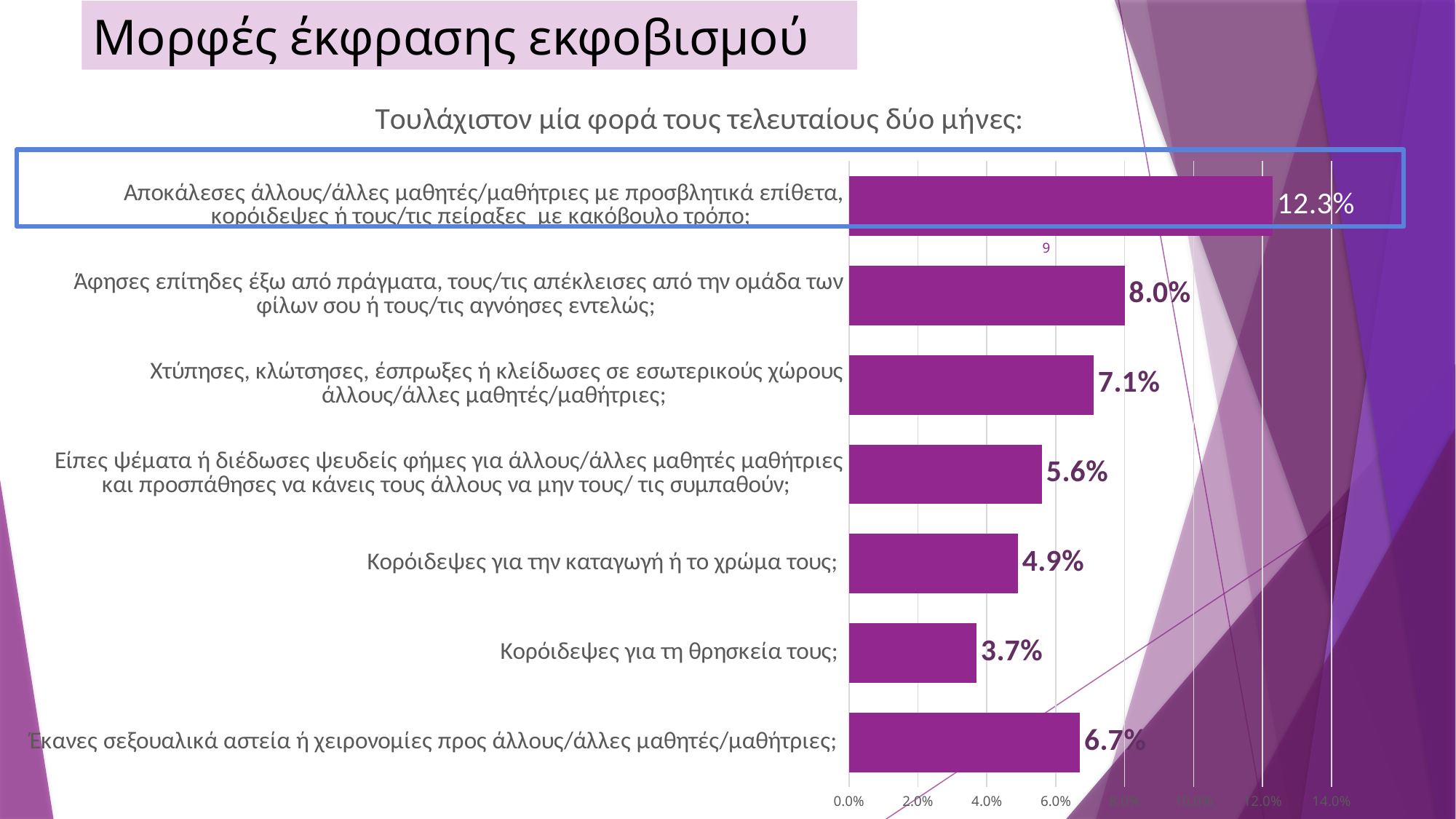
What is the value for "Έκανες σεξουαλικά αστεία ή χειρονομίες προς άλλους/άλλες μαθητές/μαθήτριες;"? 6.7% Which is larger: the value for "Είπες ψέματα ή διέδωσες ψευδείς φήμες..." or the value for "Έκανες σεξουαλικά αστεία ή χειρονομίες..."? Έκανες σεξουαλικά αστεία ή χειρονομίες προς άλλους/άλλες μαθητές/μαθήτριες; What is the value for "Κορόιδεψες για την καταγωγή ή το χρώμα τους;"? 4.9% Which category has the highest value? Αποκάλεσες άλλους/άλλες μαθητές/μαθήτριες με προσβλητικά επίθετα, κορόιδεψες ή τους/τις πείραξες με κακόβουλο τρόπο; Is the value for "Άφησες επίτηδες έξω από πράγματα..." greater or less than 10.0%? less What is the difference between the value for "Αποκάλεσες άλλους/άλλες μαθητές/μαθήτριες με προσβλητικά επίθετα..." (12.3%) and the value for "Άφησες επίτηδες έξω από πράγματα..." (8.0%)? 4.3% What is the value for "Κορόιδεψες για τη θρησκεία τους;"? 3.7% What type of chart is shown on the slide? bar chart Which category has the lowest value? Κορόιδεψες για τη θρησκεία τους; How many categories are shown in the chart? 7 What is the title of the chart? Τουλάχιστον μία φορά τους τελευταίους δύο μήνες: What is the value for "Χτύπησες, κλώτσησες, έσπρωξες ή κλείδωσες σε εσωτερικούς χώρους άλλους/άλλες μαθητές/μαθήτριες;"? 7.1%